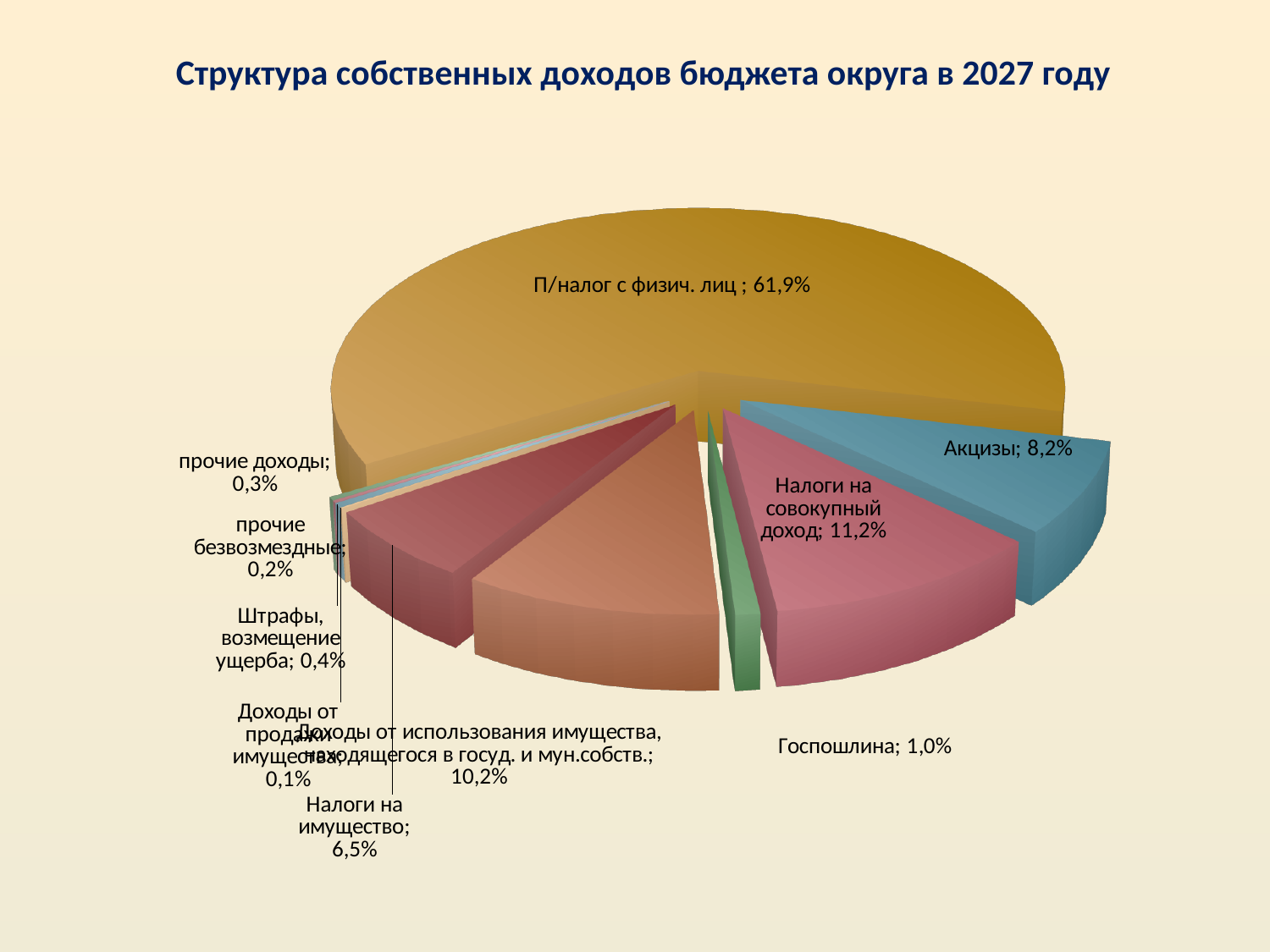
What share of the pie does П/налог с физич. лиц account for? 61,9% What is the value shown for Налоги на имущество? 6,5% What is the difference between the shares of П/налог с физич. лиц and Налоги на совокупный доход? 50,7% What is the title of the chart? Структура собственных доходов бюджета округа в 2027 году Which is larger, the share for Акцизы or the share for Налоги на имущество? Акцизы What is the value shown for Акцизы? 8,2% What is the value shown for Госпошлина? 1,0% What is the value shown for Штрафы, возмещение ущерба? 0,4% What is the value shown for Налоги на совокупный доход? 11,2% Which category has the largest share of the pie? П/налог с физич. лиц What is the value shown for Доходы от использования имущества, находящегося в госуд. и мун.собств.? 10,2% What kind of chart is shown on the slide? Pie chart